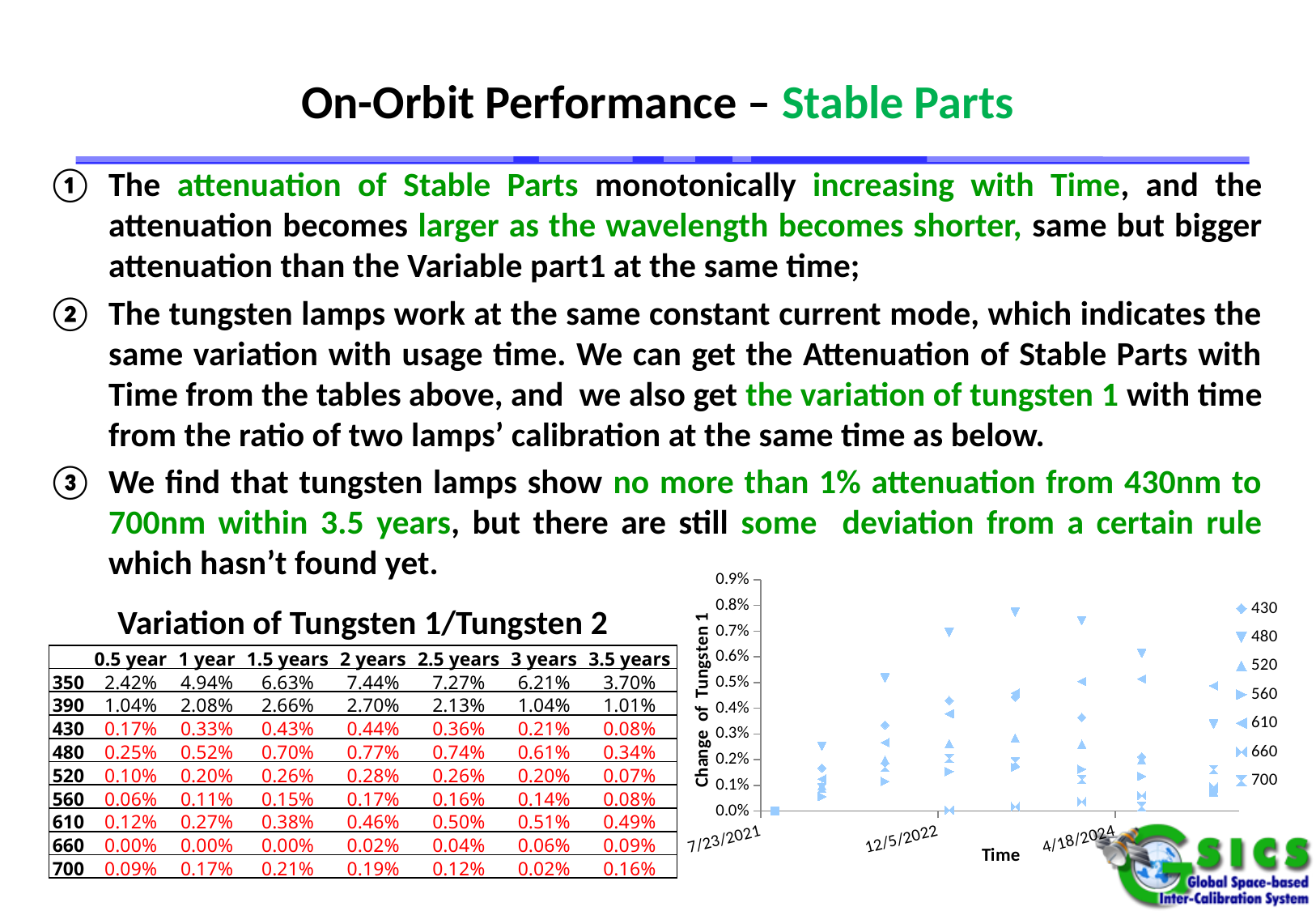
How many series does the chart legend list? 7 Which series stays lowest, closest to 0.0%, across the chart? 660 At the last time point on the chart, which is larger: the value for 610 or the value for 430? 610 What is the highest tick value shown on the chart's vertical axis? 0.9% What kind of chart is shown on the slide? scatter chart How many date labels are shown on the chart's horizontal axis? 3 What is the title of the chart's horizontal axis? Time What is the title of the chart's vertical axis? Change of Tungsten 1 Is the highest value of the 480 series greater or less than 0.7%? greater Which series reaches the highest value on the chart? 480